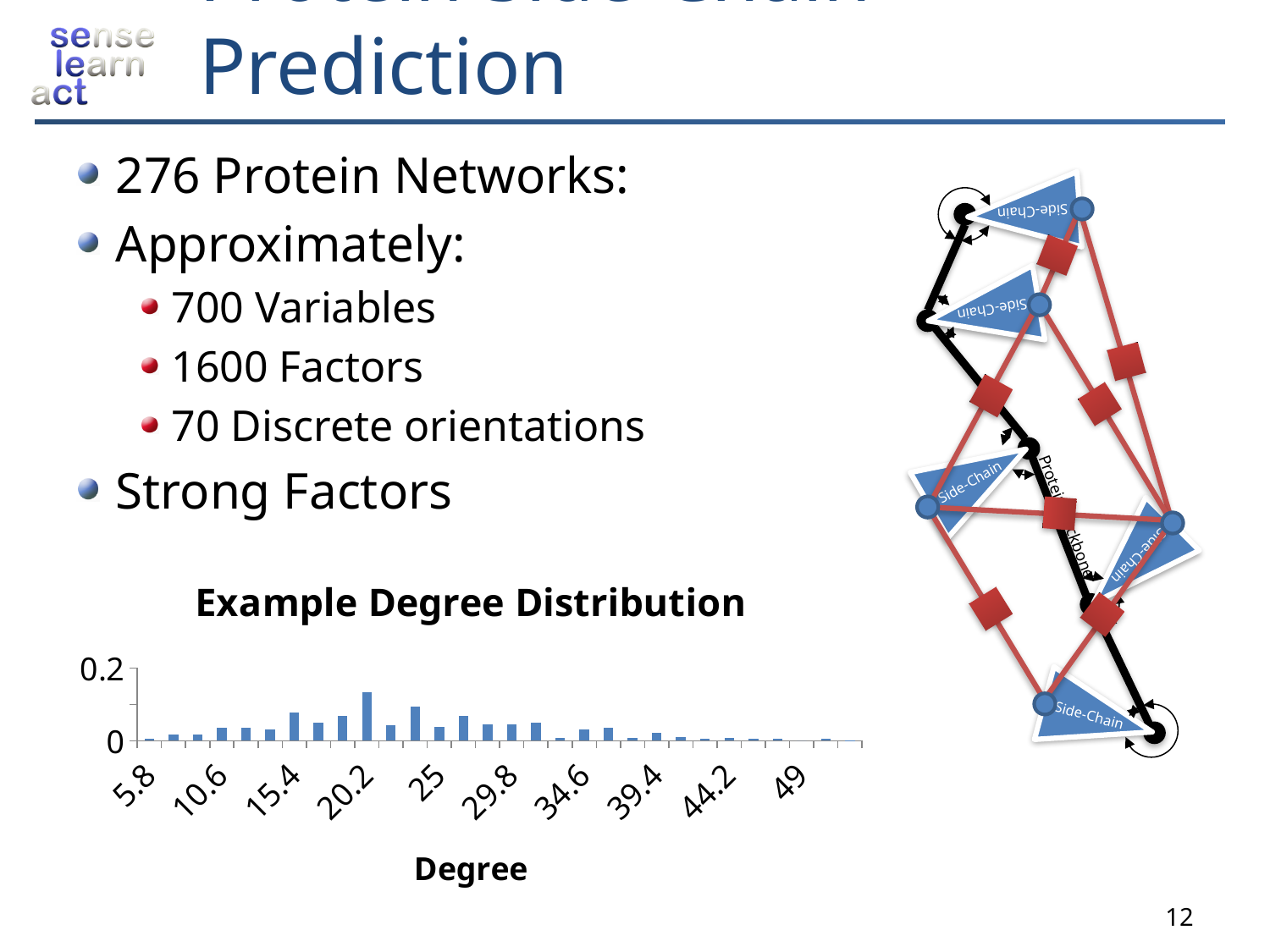
Which has the larger value, degree 5.8 or degree 15.4? 15.4 Is the highest bar in the chart greater or less than 0.1? greater What is the label of the x axis of the chart? Degree What kind of chart is shown on the slide? bar chart Is the value for degree 49 greater or less than 0.1? less Which has the larger value, degree 25 or degree 44.2? 25 Is the value for degree 5.8 greater or less than 0.1? less What is the title of the chart? Example Degree Distribution How many tick labels are shown on the x axis of the chart? 10 Do the values generally rise or fall along the x axis from degree 25 to degree 49? fall